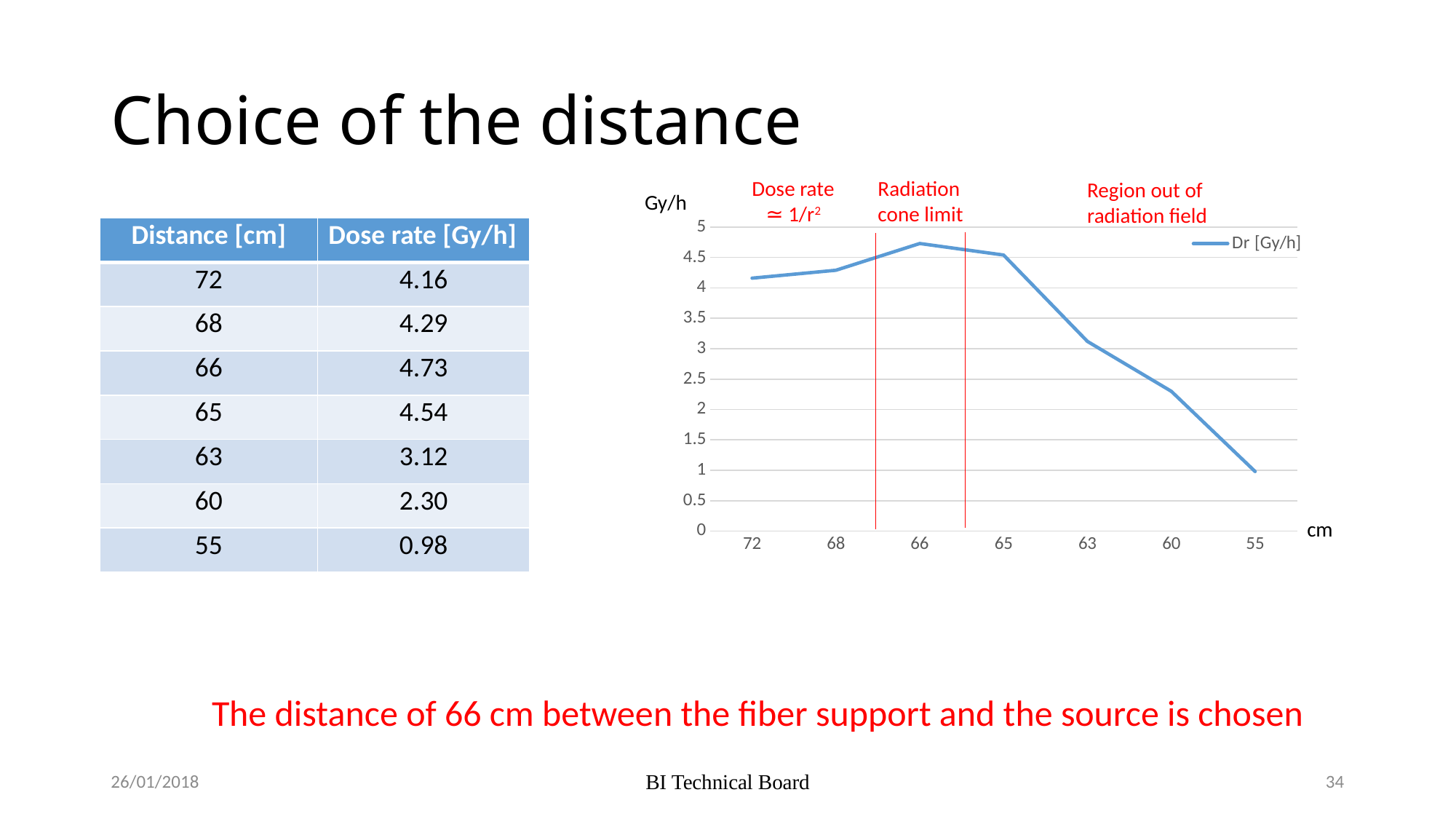
How many distance points are plotted on the chart? 7 At which distance is the dose rate highest? 66 What is the dose rate at a distance of 66 cm? 4.73 How does the dose rate change from 66 cm to 55 cm along the x axis? it falls Which has a higher dose rate, 68 cm or 60 cm? 68 cm What is the dose rate at a distance of 55 cm? 0.98 How many series does the chart legend list? 1 What is the difference between the dose rate at 66 cm and at 63 cm? 1.61 What kind of chart is shown on the slide? line chart At which distance is the dose rate lowest? 55 Is the dose rate at 63 cm greater or less than 3.5? less What is the name of the series in the chart legend? Dr [Gy/h]